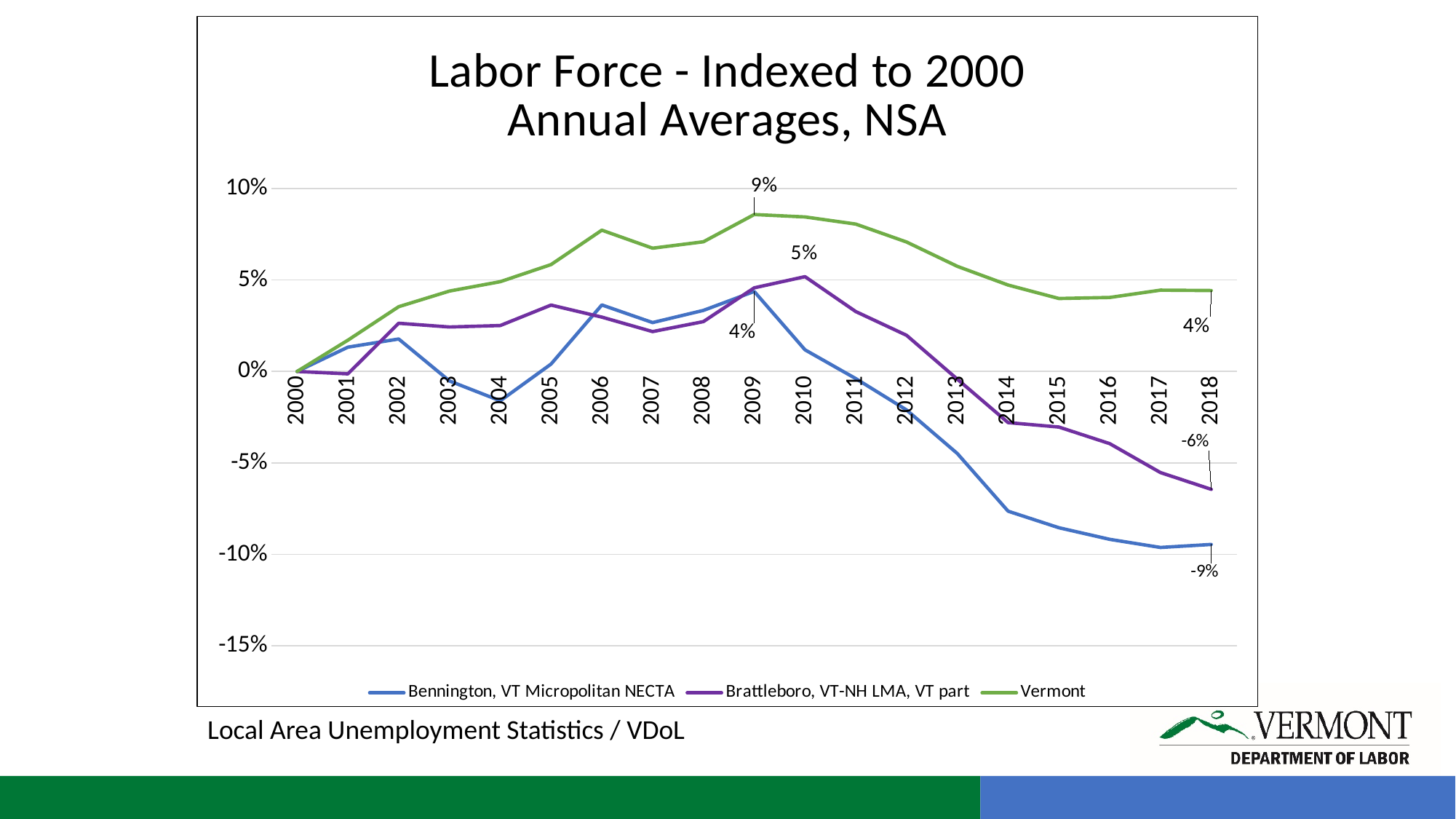
How many years are shown on the x axis? 19 What is the labeled value for Vermont in 2018? 4% What is the labeled value for Brattleboro, VT-NH LMA, VT part in 2018? -6% Does the Bennington, VT Micropolitan NECTA line rise or fall from 2009 to 2018? Fall Which series has the lowest value in 2018? Bennington, VT Micropolitan NECTA Is the value for Bennington, VT Micropolitan NECTA in 2014 greater or less than -5%? less Which series has the highest value in 2018? Vermont What is the difference between the Vermont and Bennington, VT Micropolitan NECTA values in 2018? 13 percentage points How many series does the legend list? 3 What kind of chart is shown on the slide? Line chart What is the labeled value for Bennington, VT Micropolitan NECTA in 2018? -9% What is the labeled value for Vermont in 2009? 9%